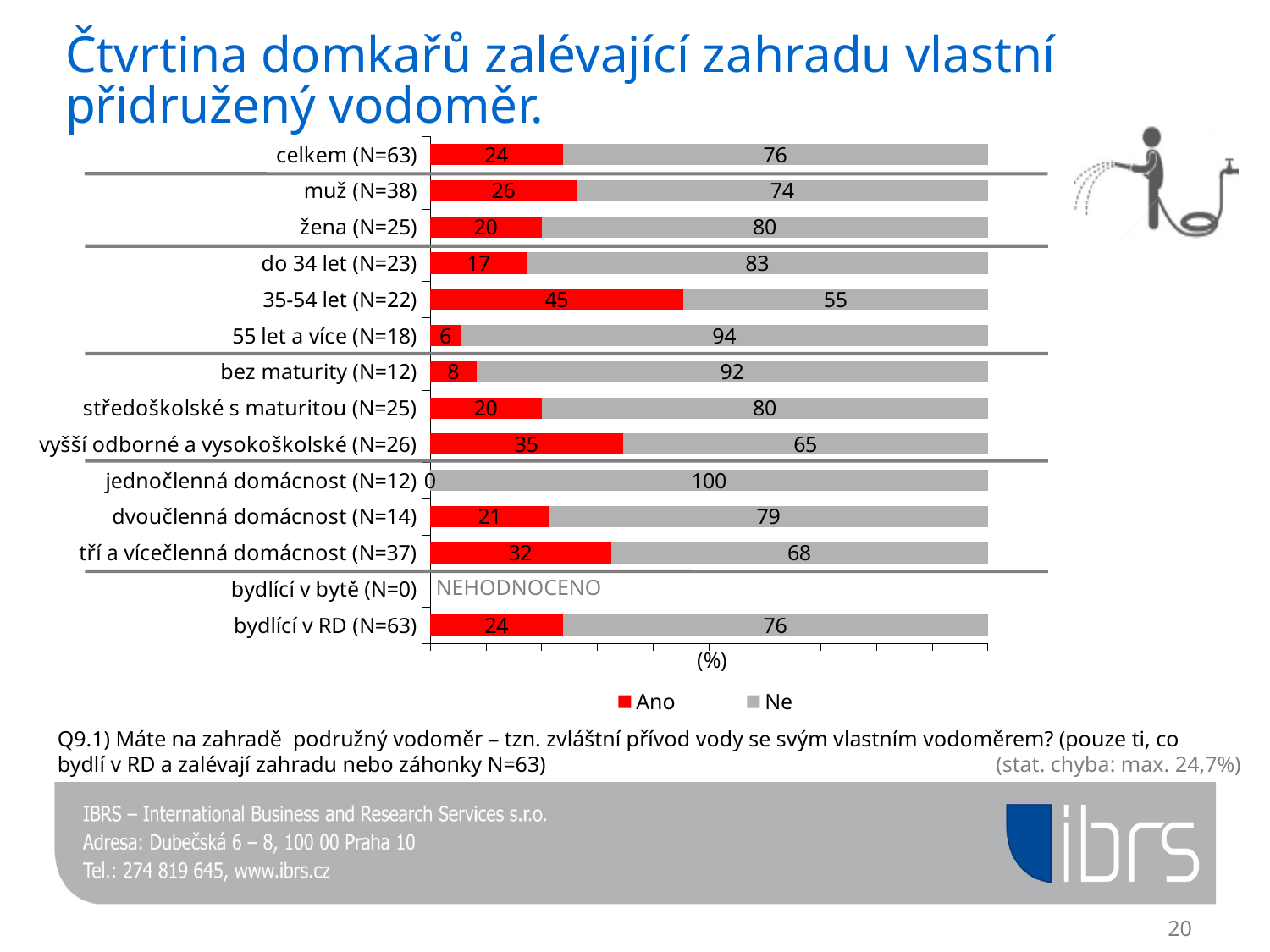
What kind of chart is shown on the slide? Stacked bar chart What is the difference between the "Ano" values for "muž (N=38)" and "žena (N=25)"? 6 What is the total of the stacked bar for "tří a vícečlenná domácnost (N=37)"? 100 Which category has the lowest "Ano" value? jednočlenná domácnost (N=12) What is the "Ano" value for "35-54 let (N=22)"? 45 Which colour represents the "Ano" series? Red Which category has the highest "Ano" value? 35-54 let (N=22) Which has a larger "Ano" value: "do 34 let (N=23)" or "55 let a více (N=18)"? do 34 let (N=23) What is the "Ano" value for "vyšší odborné a vysokoškolské (N=26)"? 35 How many series does the legend list? 2 What text is shown in place of a bar for "bydlící v bytě (N=0)"? NEHODNOCENO What is the "Ne" value for "bez maturity (N=12)"? 92